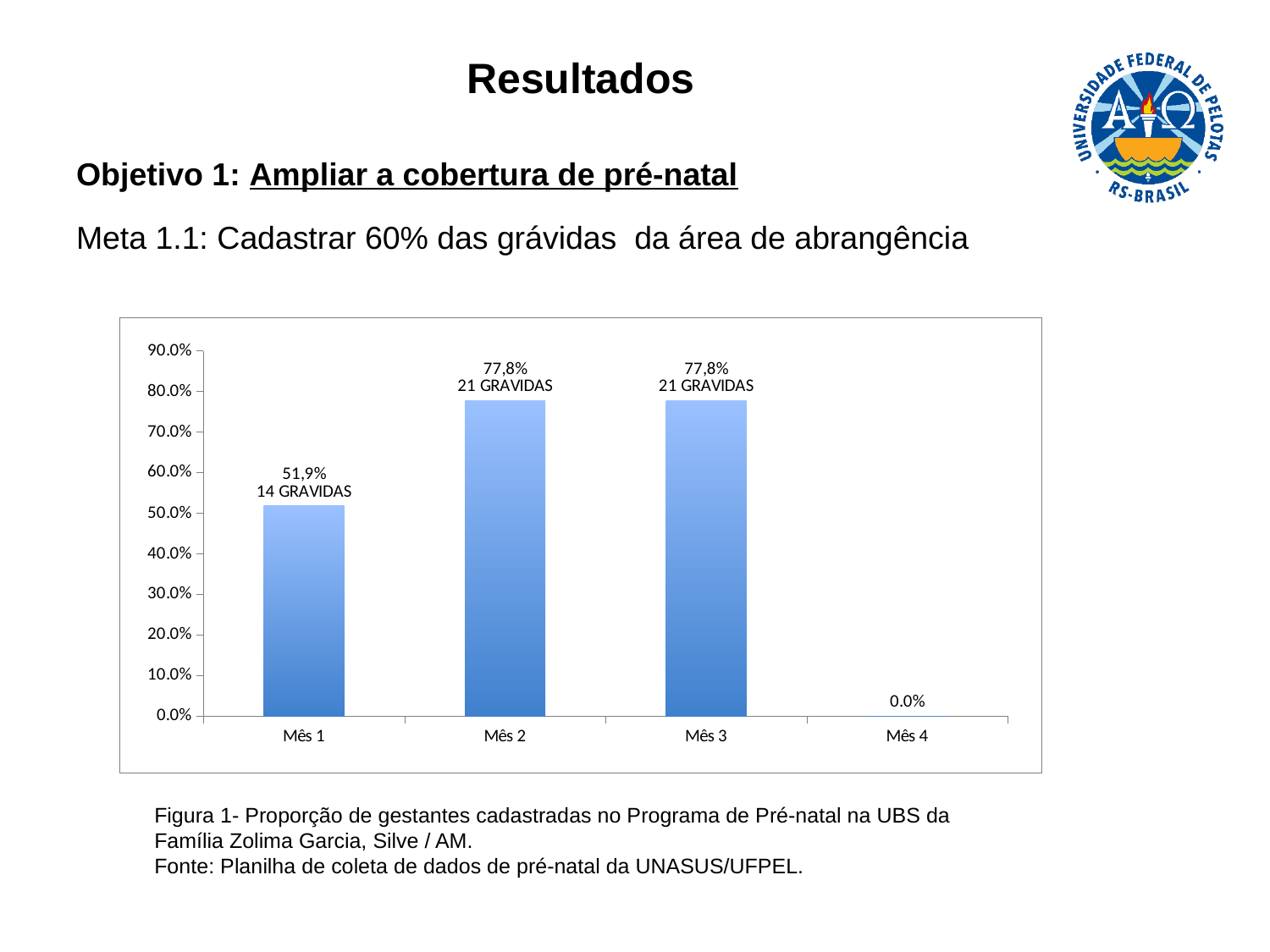
What is the value shown for Mês 4? 0.0% What kind of chart is shown on the slide? bar chart How many pregnant women (GRAVIDAS) are labelled for Mês 1? 14 GRAVIDAS Which month has the lowest value? Mês 4 How many pregnant women (GRAVIDAS) are labelled for Mês 3? 21 GRAVIDAS How many months (categories) are shown on the x axis? 4 Is the value for Mês 1 greater or less than 60.0%? less What is the value shown for Mês 1? 51,9% What is the value shown for Mês 2? 77,8% What is the highest value shown on the y axis? 90.0% Which is larger, the value for Mês 1 or the value for Mês 3? Mês 3 What is the difference between the values for Mês 2 and Mês 1? 25,9%